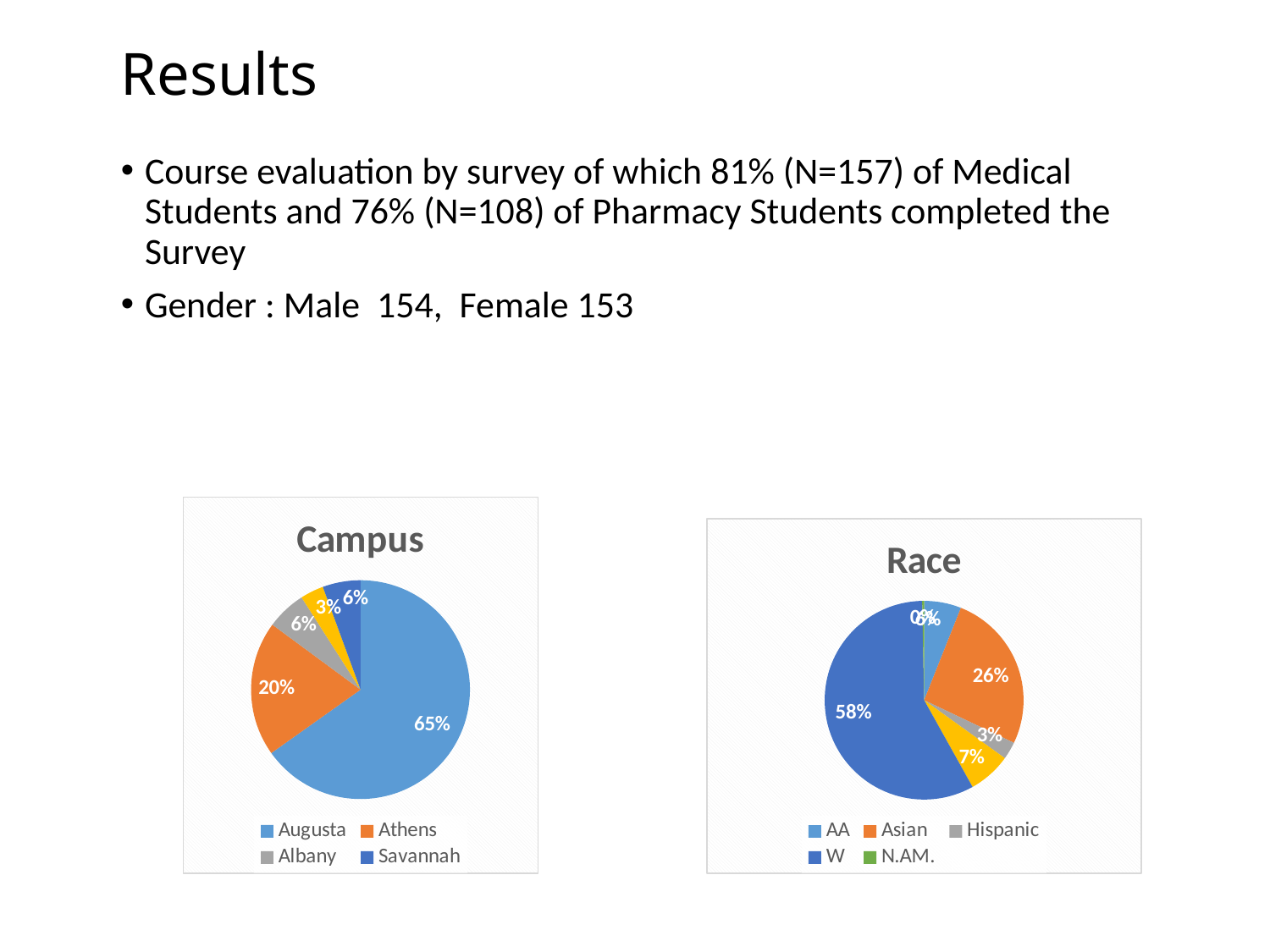
In the Race pie chart, what share does W have? 58% What type of chart is the Campus chart? Pie chart In the Campus pie chart, how many percentage points larger is Augusta's share than Athens's share? 45% In the Campus pie chart, what share does Athens have? 20% In the Race pie chart, which is larger, the Asian slice or the Hispanic slice? Asian How many entries does the legend of the Campus chart list? 4 In the Race pie chart, which category has the largest slice? W In the Campus pie chart, what share does Albany have? 6% In the Campus pie chart, which campus has the largest slice? Augusta In the Race pie chart, what share does Asian have? 26% In the Campus pie chart, what share does Augusta have? 65% In the Race pie chart, what share does Hispanic have? 3%